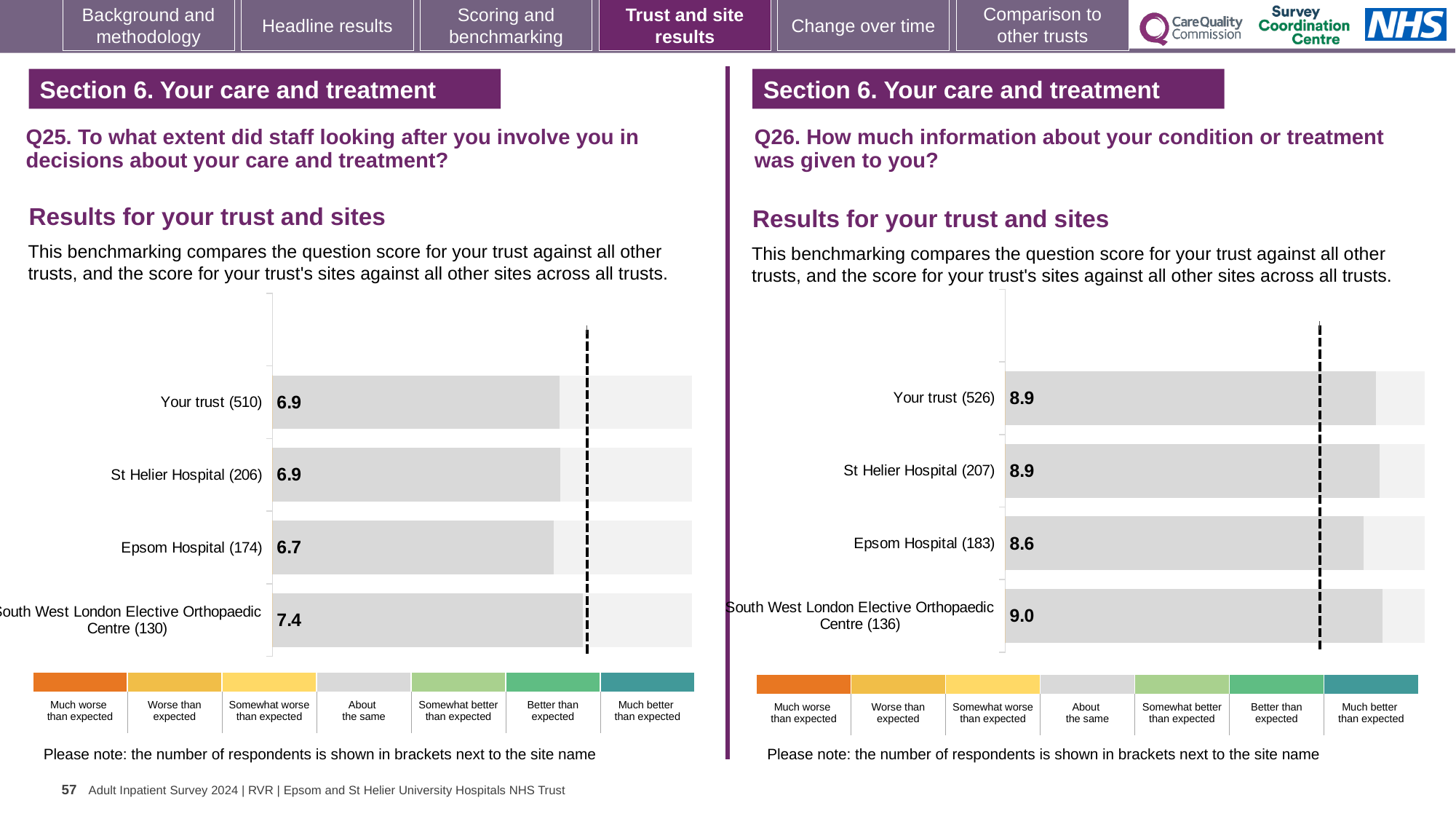
In the Q26 chart on the right, what is the score for Your trust (526)? 8.9 In the Q25 chart on the left, which site has the highest score? South West London Elective Orthopaedic Centre (130) What kind of chart is used for the Q26 results on the right? Bar chart In the Q26 chart on the right, which is larger: the score for St Helier Hospital (207) or Epsom Hospital (183)? St Helier Hospital (207) In the Q25 chart on the left, what is the score for Your trust (510)? 6.9 How many bars are plotted in the Q25 chart on the left? 4 In the Q26 chart on the right, which site has the lowest score? Epsom Hospital (183) In the Q25 chart on the left, what is the score for Epsom Hospital (174)? 6.7 In the Q25 chart on the left, what is the difference between the scores for South West London Elective Orthopaedic Centre (130) and Epsom Hospital (174)? 0.7 In the Q26 chart on the right, what is the score for South West London Elective Orthopaedic Centre (136)? 9.0 In the Q26 chart on the right, what is the difference between the scores for South West London Elective Orthopaedic Centre (136) and Epsom Hospital (183)? 0.4 In the Q25 chart on the left, which site has the lowest score? Epsom Hospital (174)